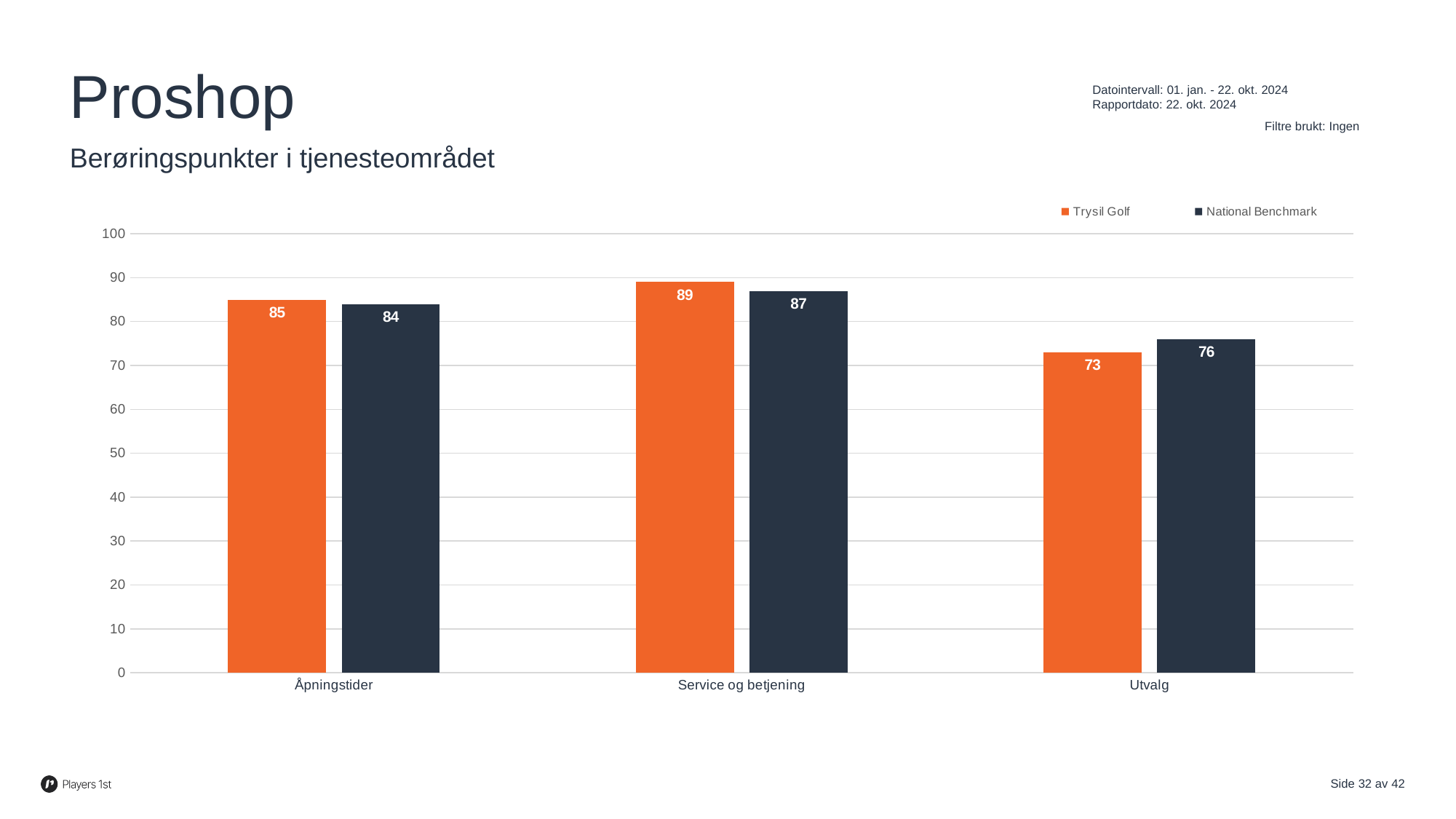
What is the difference between the Trysil Golf values for Service og betjening and Utvalg? 16 What is the difference between the Trysil Golf and National Benchmark values for Utvalg? 3 What kind of chart is shown on the slide? Bar chart What is the National Benchmark value for Service og betjening? 87 Which series is shown in orange? Trysil Golf How many series does the legend list? 2 What is the Trysil Golf value for Utvalg? 73 Which category has the highest Trysil Golf value? Service og betjening For Utvalg, which is larger: Trysil Golf or National Benchmark? National Benchmark Which category has the lowest National Benchmark value? Utvalg What is the Trysil Golf value for Åpningstider? 85 How many categories are shown on the x axis? 3